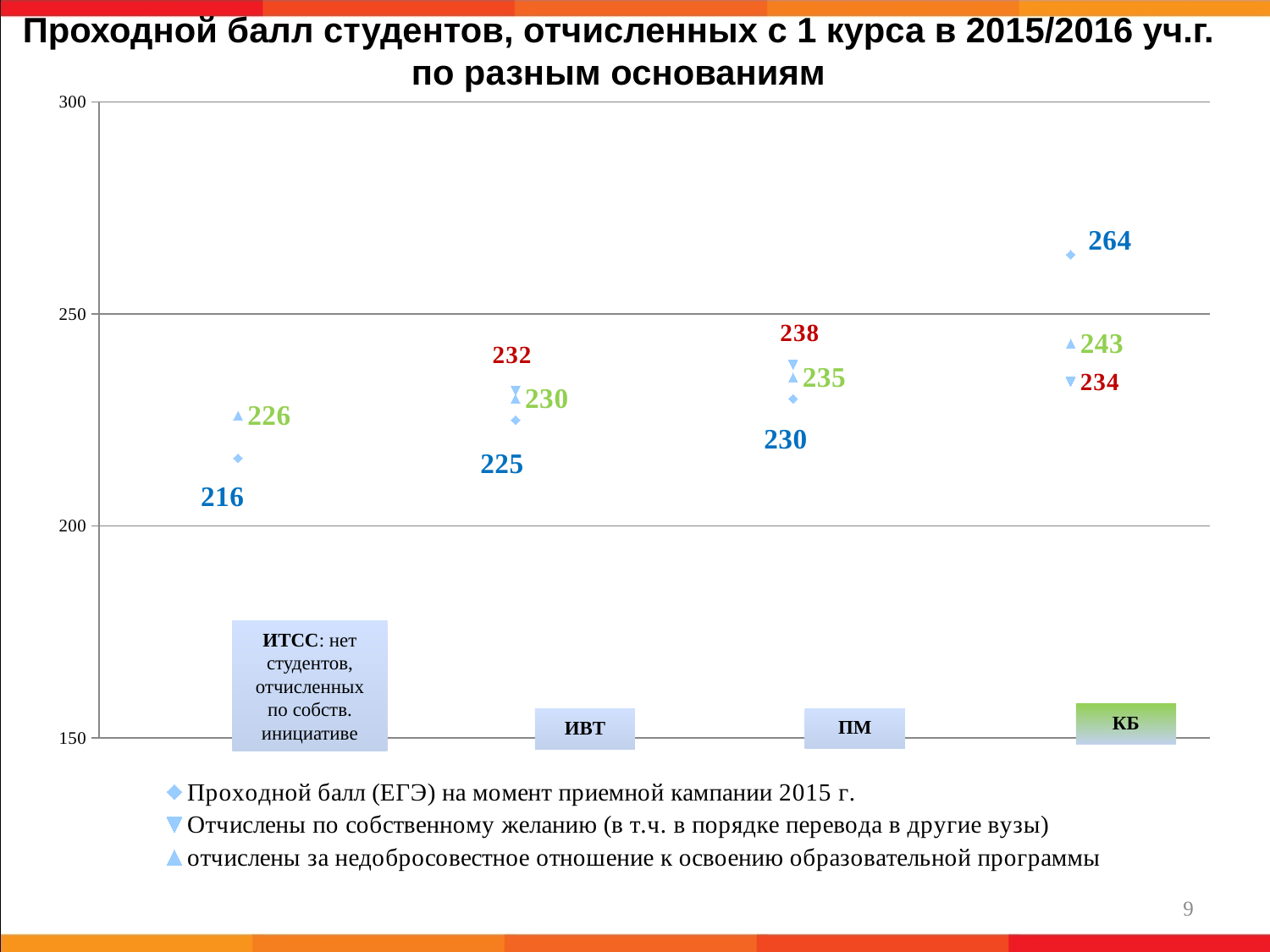
Which category has the lowest value for 'Проходной балл (ЕГЭ) на момент приемной кампании 2015 г.'? ИТСС Does the 'Проходной балл (ЕГЭ)' series rise or fall from ИТСС to КБ? rise What is the value of the series 'Проходной балл (ЕГЭ) на момент приемной кампании 2015 г.' for КБ? 264 How many categories are shown on the x axis of the chart? 4 How many series does the legend list? 3 What is the difference between the 'Проходной балл (ЕГЭ)' values for КБ and ИТСС? 48 Which category has no students expelled by their own initiative, according to the note on the chart? ИТСС For ПМ, which is larger: the value for 'Отчислены по собственному желанию' or for 'отчислены за недобросовестное отношение'? Отчислены по собственному желанию What is the value of the series 'отчислены за недобросовестное отношение к освоению образовательной программы' for ИТСС? 226 What is the value of the series 'Отчислены по собственному желанию' for ИВТ? 232 What is the value of the series 'отчислены за недобросовестное отношение к освоению образовательной программы' for ПМ? 235 Which category has the highest value for 'Проходной балл (ЕГЭ) на момент приемной кампании 2015 г.'? КБ